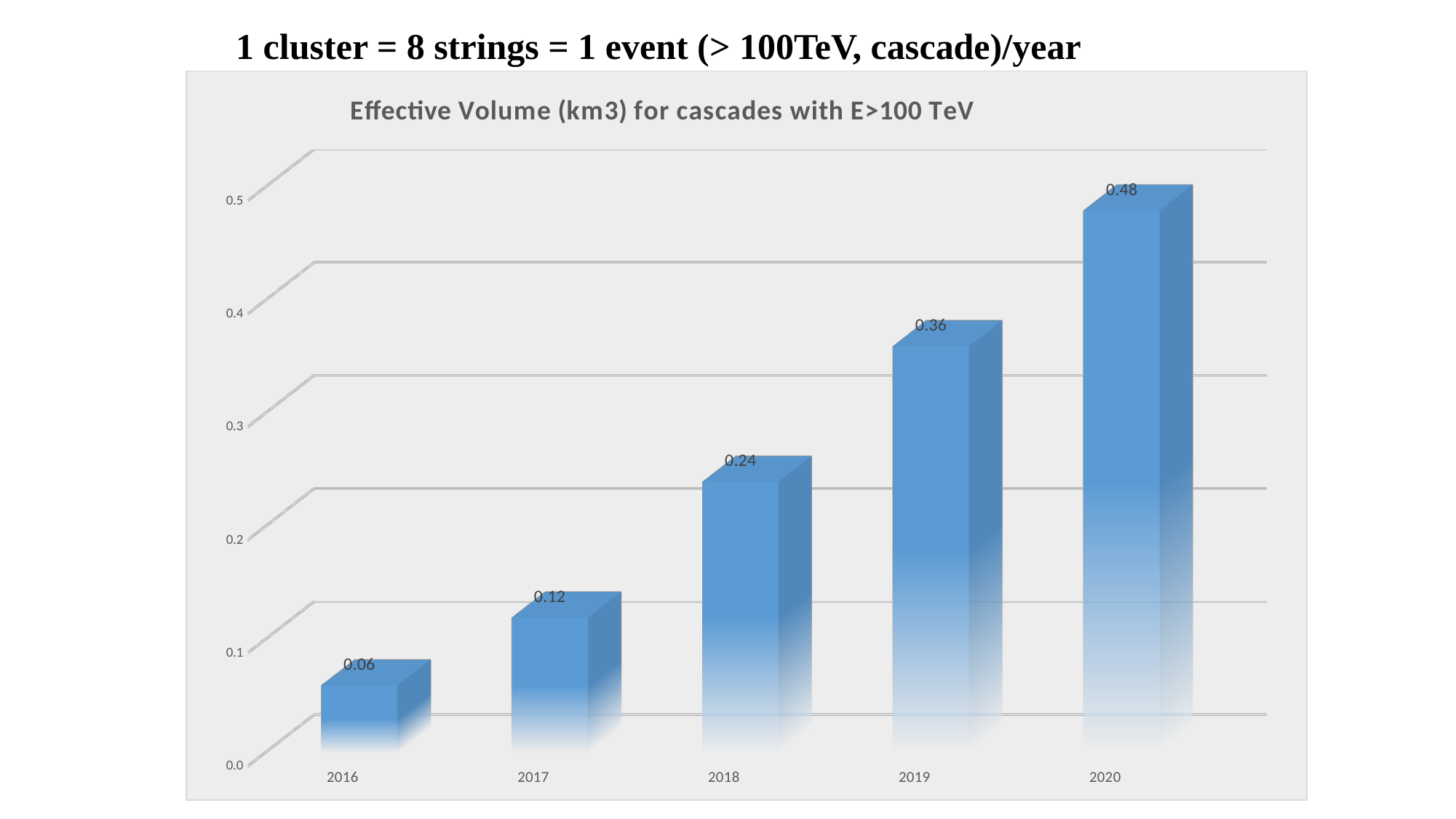
Do the effective volume values rise or fall from 2016 to 2020? rise What is the effective volume for 2018? 0.24 What is the effective volume for 2020? 0.48 What is the difference between the effective volume in 2019 and in 2017? 0.24 How many years are shown on the x axis? 5 Which year has the highest effective volume? 2020 What kind of chart is shown on the slide? bar chart What is the effective volume for 2016? 0.06 Which year has the lowest effective volume? 2016 What is the title of the chart? Effective Volume (km3) for cascades with E>100 TeV Is the value for 2019 greater or less than 0.3? greater Which year has a larger effective volume, 2018 or 2019? 2019